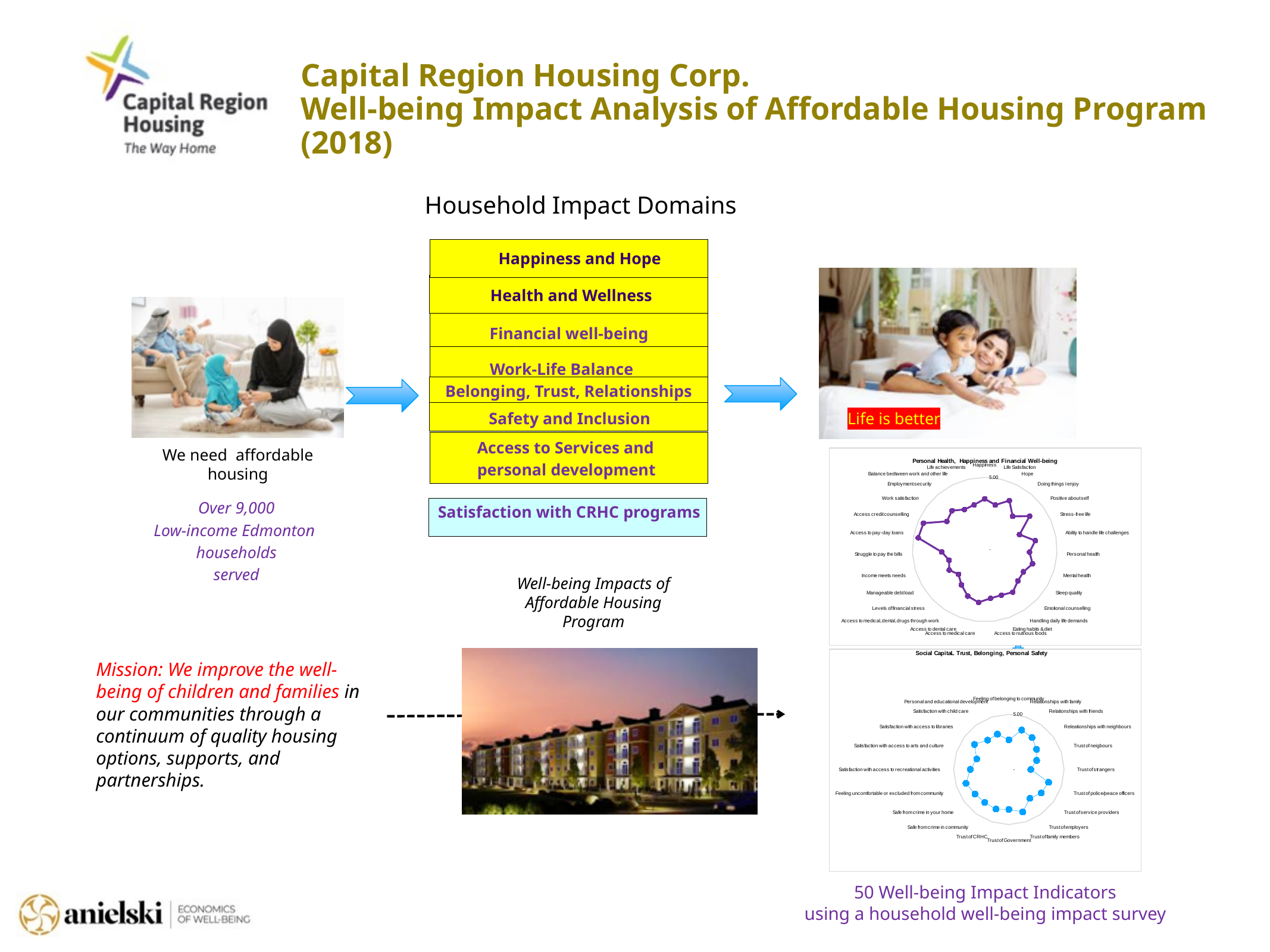
What kind of chart is the bottom chart on the right, titled "Social Capital, Trust, Belonging, Personal Safety"? Radar chart In the "Social Capital, Trust, Belonging, Personal Safety" chart, is the value for Relationships with family greater or less than 5.00? less What kind of chart is the top chart on the right, titled "Personal Health, Happiness and Financial Well-being"? Radar chart In the "Personal Health, Happiness and Financial Well-being" chart, which is larger: the value for Access to pay-day loans or the value for Mental health? Access to pay-day loans How many data series are plotted in the "Social Capital, Trust, Belonging, Personal Safety" chart? 1 How many data series are plotted in the "Personal Health, Happiness and Financial Well-being" chart? 1 In the "Personal Health, Happiness and Financial Well-being" chart, is the value for Happiness greater or less than 5.00? less In the "Personal Health, Happiness and Financial Well-being" chart, is the value for Access to pay-day loans greater or less than the value for Sleep quality? greater What is the title of the upper radar chart on the right side of the slide? Personal Health, Happiness and Financial Well-being What colour is the data line in the lower radar chart titled "Social Capital, Trust, Belonging, Personal Safety"? Blue